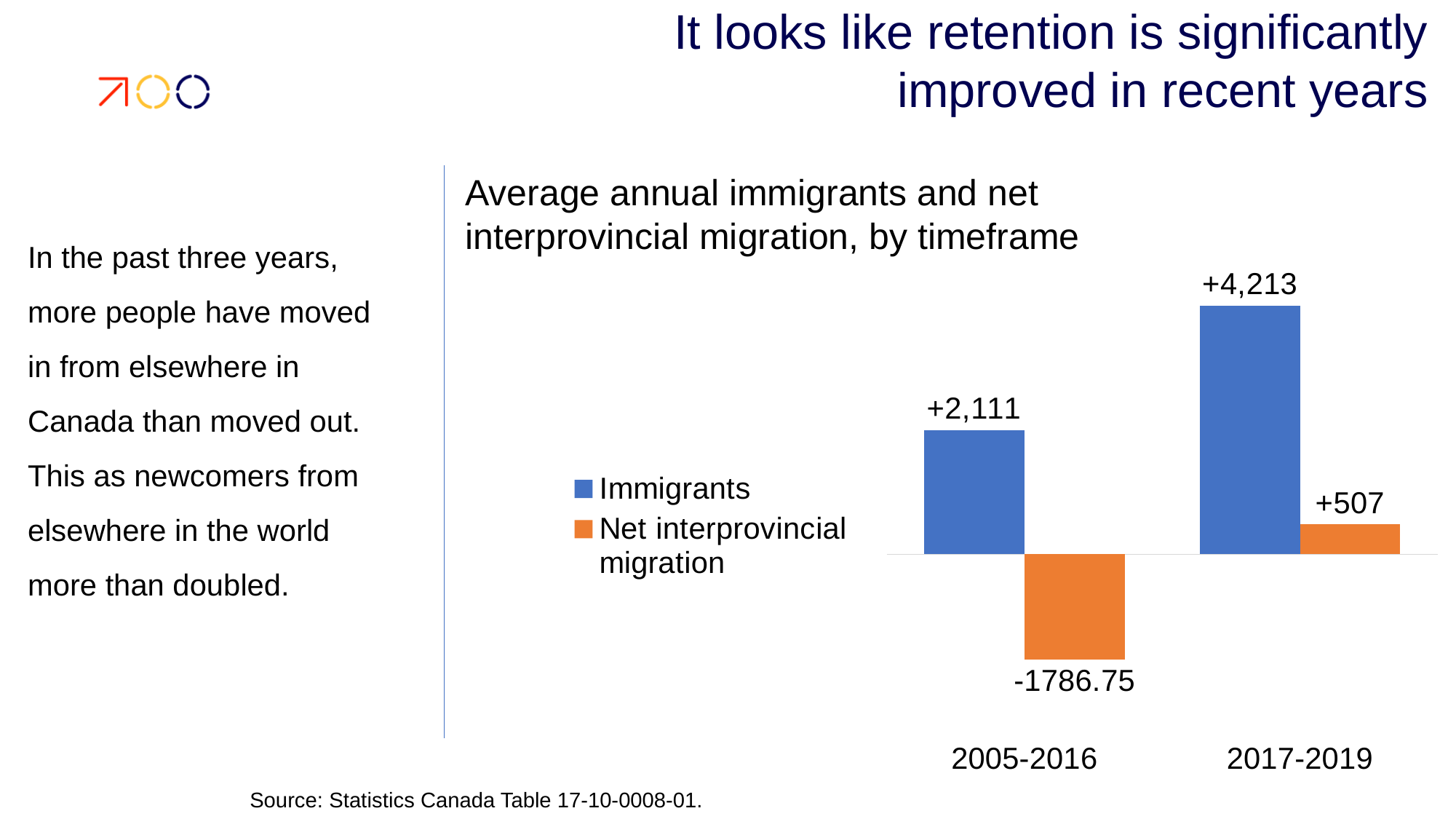
What is the difference between the Immigrants values for 2017-2019 and 2005-2016? 2,102 Which timeframe has the lowest value for Net interprovincial migration? 2005-2016 How many timeframes are shown on the x axis? 2 What is the value for Net interprovincial migration in 2017-2019? +507 What is the value for Net interprovincial migration in 2005-2016? -1786.75 What is the title of the chart? Average annual immigrants and net interprovincial migration, by timeframe Which timeframe has the higher value for Immigrants? 2017-2019 How many series does the legend list? 2 What is the value for Immigrants in 2017-2019? +4,213 What is the value for Immigrants in 2005-2016? +2,111 What kind of chart is shown on the slide? Bar chart Is the Immigrants value larger in 2005-2016 or in 2017-2019? 2017-2019